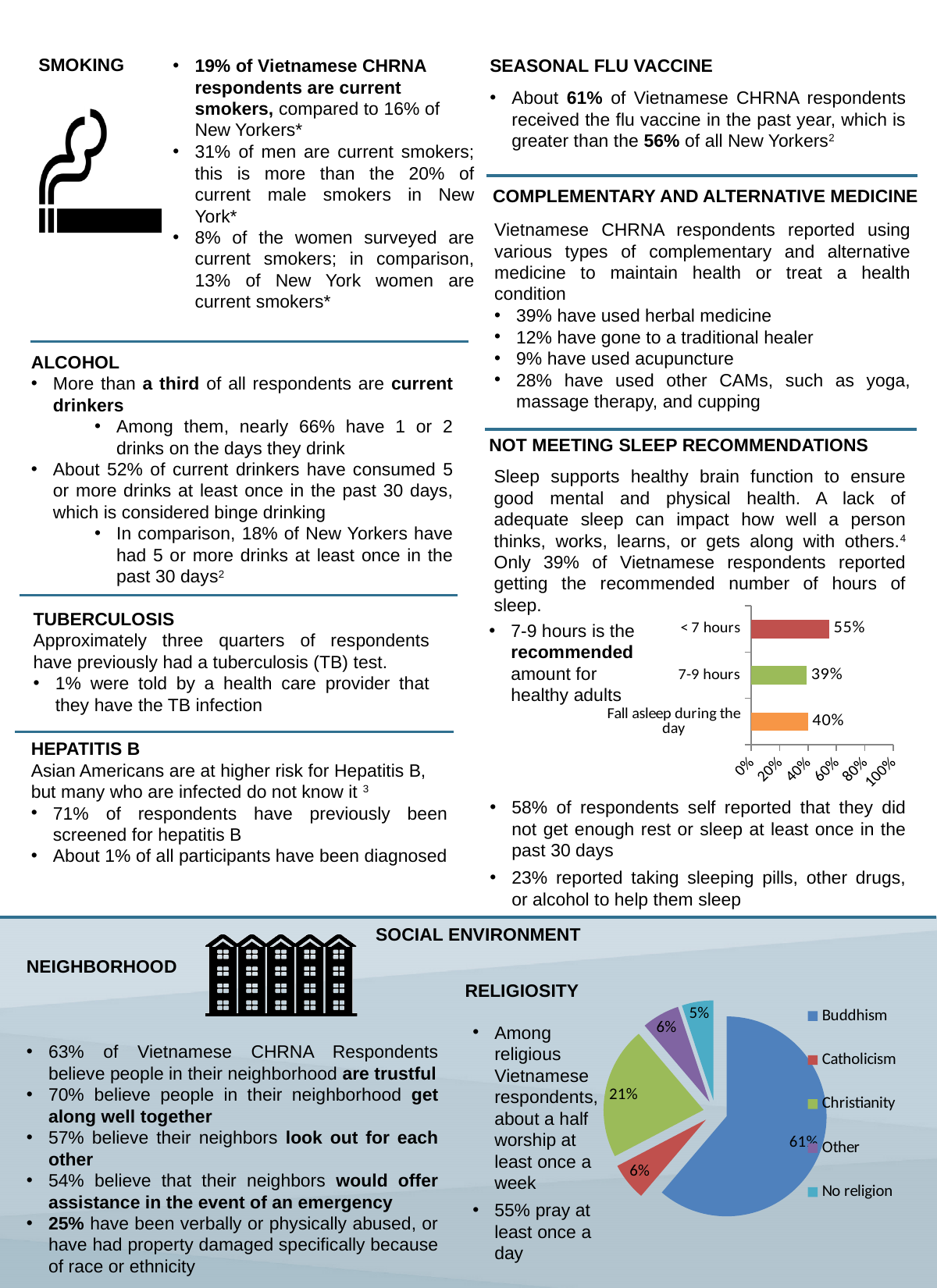
In the religiosity pie chart, which religion has the smallest share? No religion In the sleep bar chart, what is the value for '< 7 hours'? 55% What kind of chart is used in the 'Not Meeting Sleep Recommendations' section? Bar chart In the sleep bar chart, what is the value for 'Fall asleep during the day'? 40% In the religiosity pie chart, which is larger: Christianity or Catholicism? Christianity In the religiosity pie chart, what share is Christianity? 21% In the sleep bar chart, what is the difference between '< 7 hours' and '7-9 hours'? 16% In the religiosity pie chart, how many entries does the legend list? 5 In the sleep bar chart, how many categories are shown? 3 In the religiosity pie chart, what share is Buddhism? 61% In the sleep bar chart, what is the value for '7-9 hours'? 39% In the sleep bar chart, which category has the highest value? < 7 hours